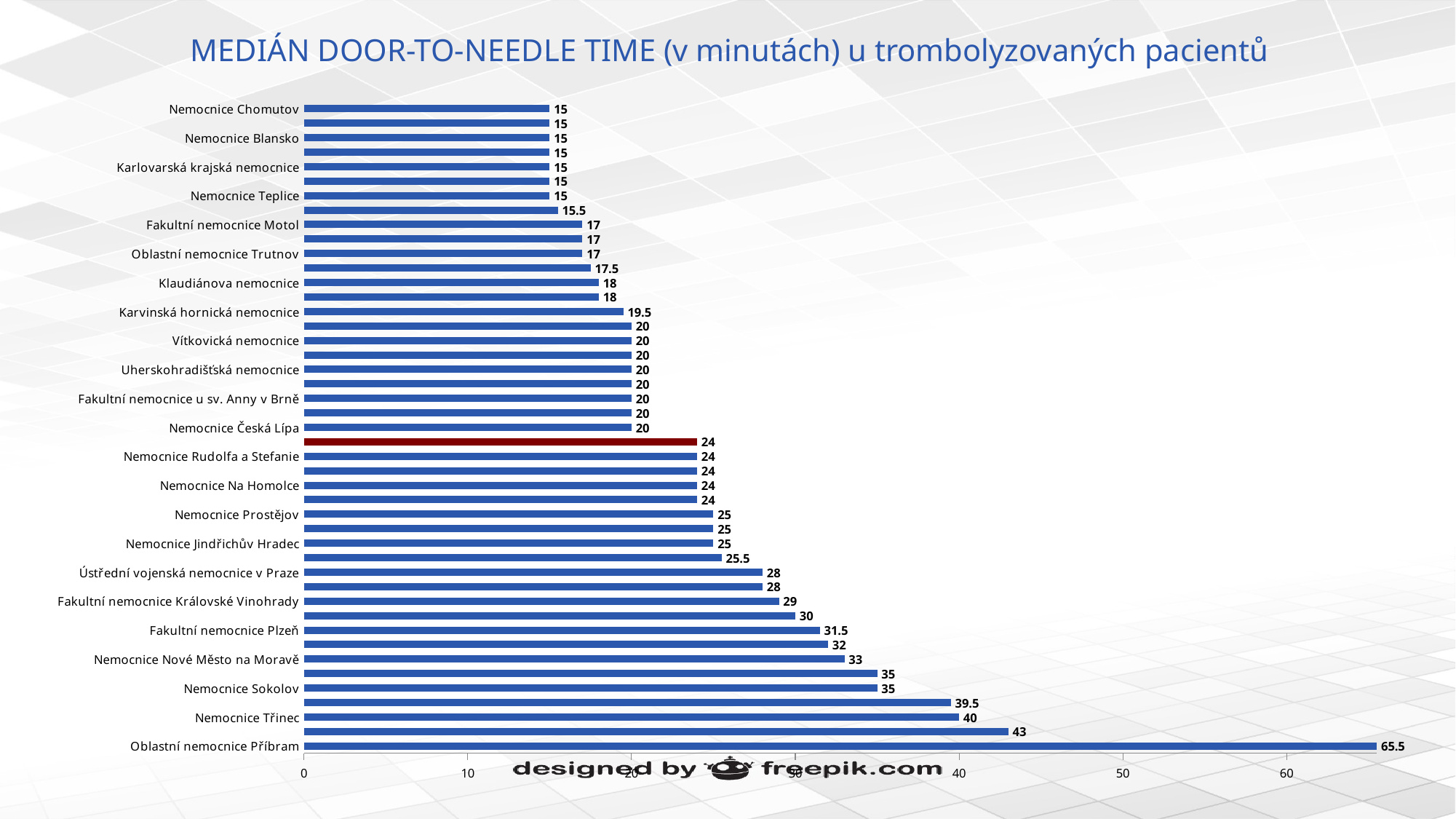
What is the value shown for Fakultní nemocnice Plzeň? 31.5 What value is labelled on the single red bar in the chart? 24 What is the difference between the values for Oblastní nemocnice Příbram and Nemocnice Třinec? 25.5 What is the lowest value shown on the chart? 15 What is the value shown for Karvinská hornická nemocnice? 19.5 Which hospital has the highest median door-to-needle time? Oblastní nemocnice Příbram What is the value shown for Nemocnice Třinec? 40 What kind of chart is shown on the slide? bar chart What is the median door-to-needle time for Oblastní nemocnice Příbram? 65.5 Which has a larger value, Nemocnice Sokolov or Nemocnice Nové Město na Moravě? Nemocnice Sokolov Is the value for Oblastní nemocnice Příbram greater or less than 60? greater What is the difference between the values for Fakultní nemocnice Plzeň and Fakultní nemocnice Motol? 14.5